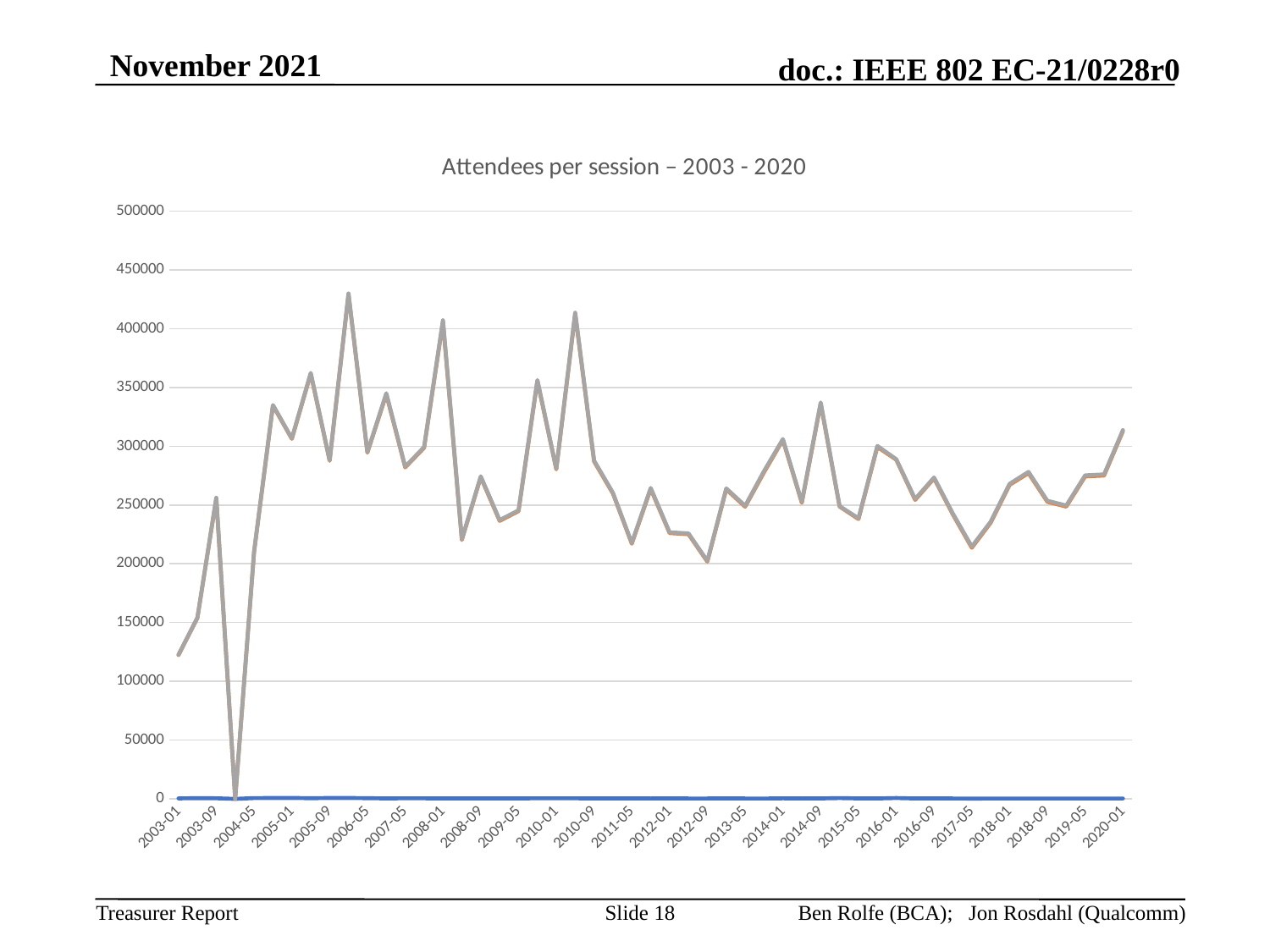
Which labelled session has the lowest value on the chart? 2003-01 Which is larger, the value for 2005-01 or the value for 2017-05? 2005-01 Is the value for 2020-01 greater or less than 300000? greater What is the highest value shown on the vertical axis of the chart? 500000 Is the value for 2003-09 greater or less than 200000? greater Is the value for 2017-05 greater or less than 250000? less What kind of chart is shown on the slide? line chart Which is larger, the value for 2003-01 or the value for 2020-01? 2020-01 What is the title of the chart? Attendees per session – 2003 - 2020